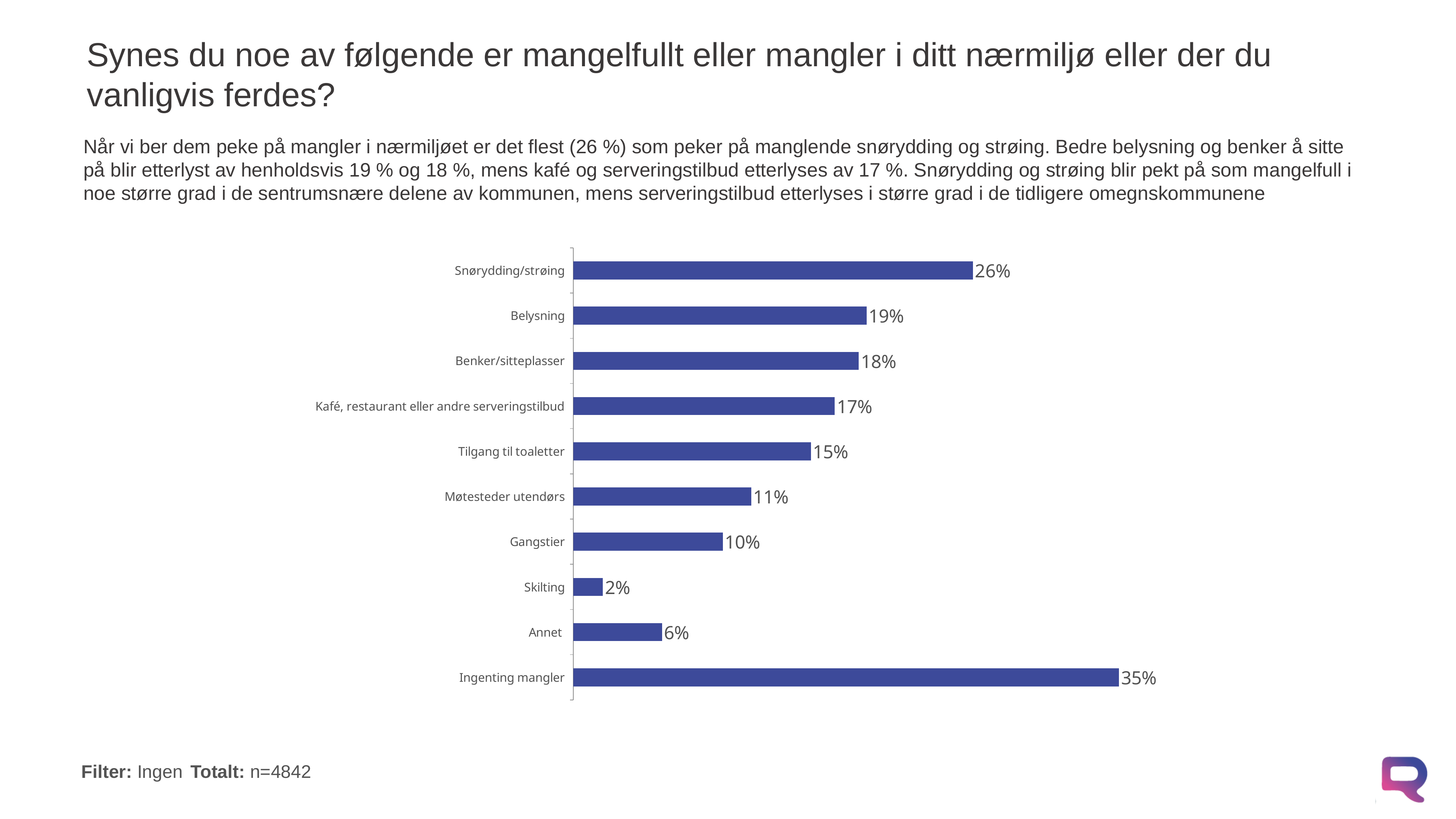
What is the value for Tilgang til toaletter? 15% How many categories are shown in the chart? 10 What is the value for Møtesteder utendørs? 11% What is the total sample size shown at the bottom of the slide? n=4842 What is the value for Ingenting mangler? 35% What kind of chart is shown on the slide? Bar chart Which category has the lowest value? Skilting What is the value for Snørydding/strøing? 26% Which category has the highest value? Ingenting mangler What is the difference between Ingenting mangler and Snørydding/strøing? 9% What is the difference between Belysning and Gangstier? 9% Which is larger, Benker/sitteplasser or Kafé, restaurant eller andre serveringstilbud? Benker/sitteplasser